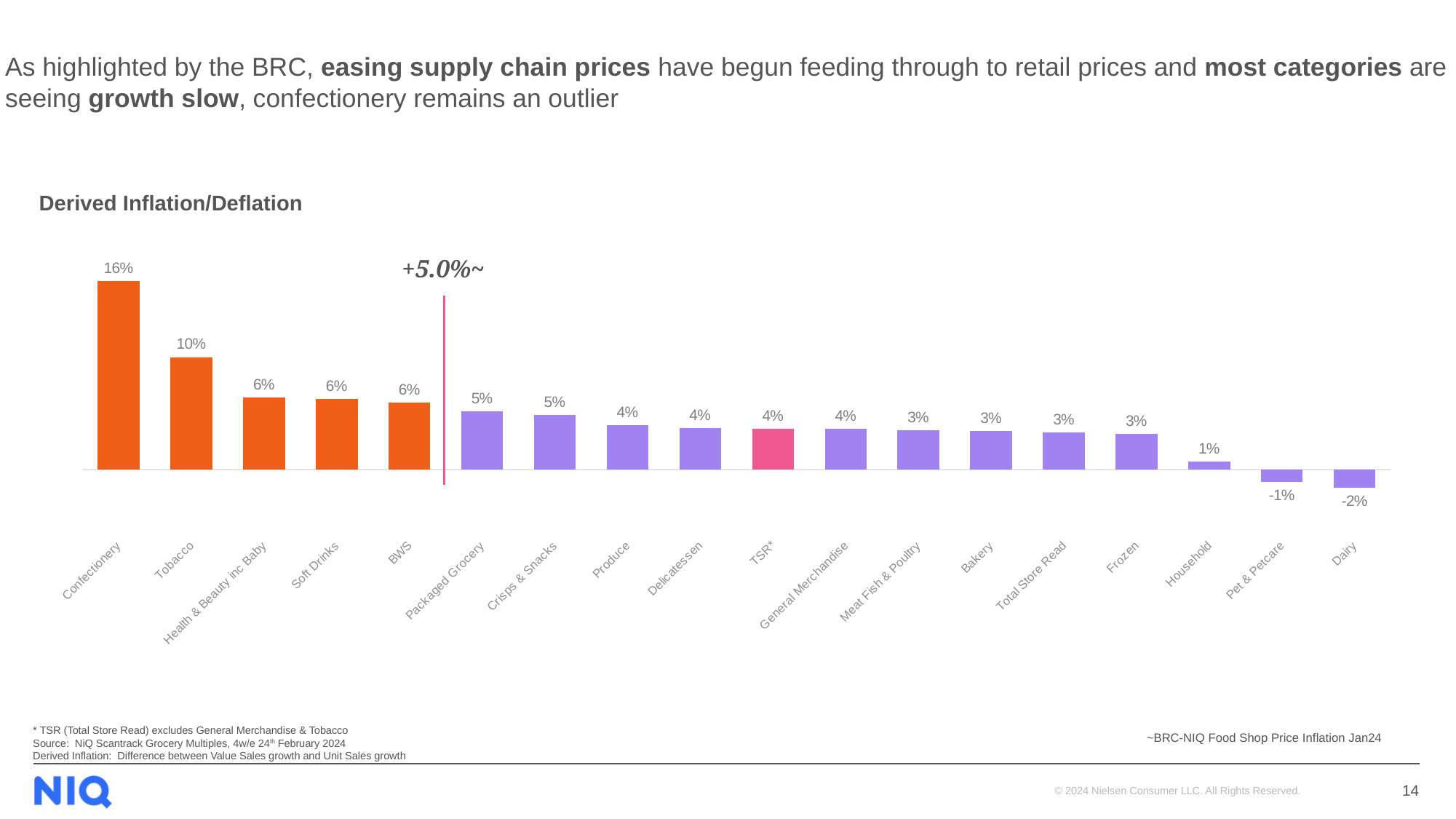
What is the title of the chart? Derived Inflation/Deflation What is the difference between the values for Confectionery and Tobacco? 6% What is the derived inflation value for Confectionery? 16% Which has a higher value, Packaged Grocery or Frozen? Packaged Grocery What is the value shown for Dairy? -2% What is the value shown for Household? 1% What kind of chart is shown on the slide? Bar chart Do the values rise or fall moving from left to right along the x axis? Fall Which category has the highest derived inflation? Confectionery How many categories are shown on the chart? 18 Which category has the lowest derived inflation? Dairy What is the derived inflation value for Tobacco? 10%